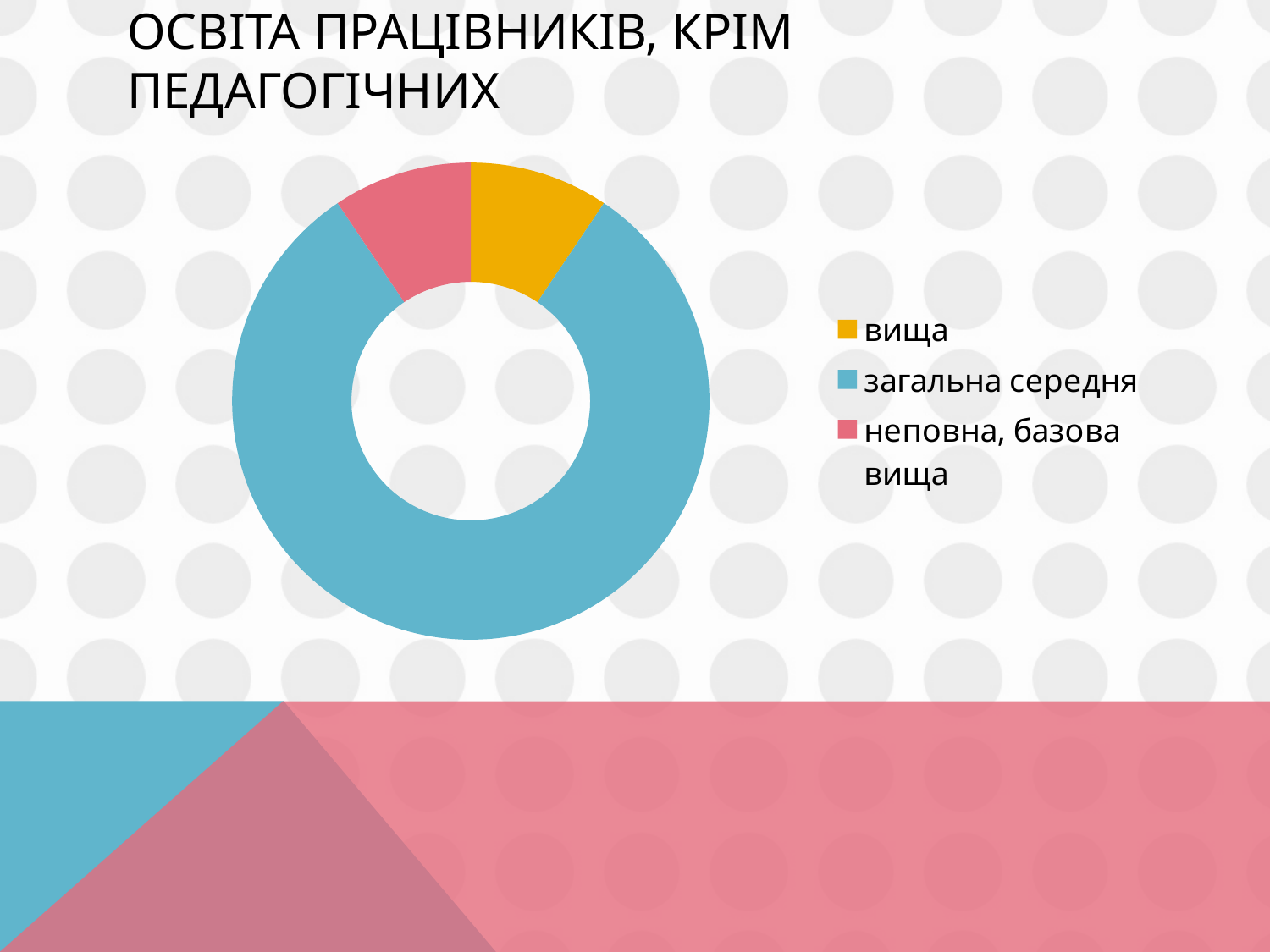
Does the category загальна середня account for more or less than half of the chart? more How many categories does the chart show? 3 Which is larger: the share for загальна середня or the share for вища? загальна середня How many entries does the legend list? 3 Which category has the largest share of the chart? загальна середня What is the title of the chart on the slide? ОСВІТА ПРАЦІВНИКІВ, КРІМ ПЕДАГОГІЧНИХ What kind of chart is shown on the slide? Doughnut (pie) chart Which is larger: the share for загальна середня or the share for неповна, базова вища? загальна середня Which colour represents the category вища in the chart? Yellow